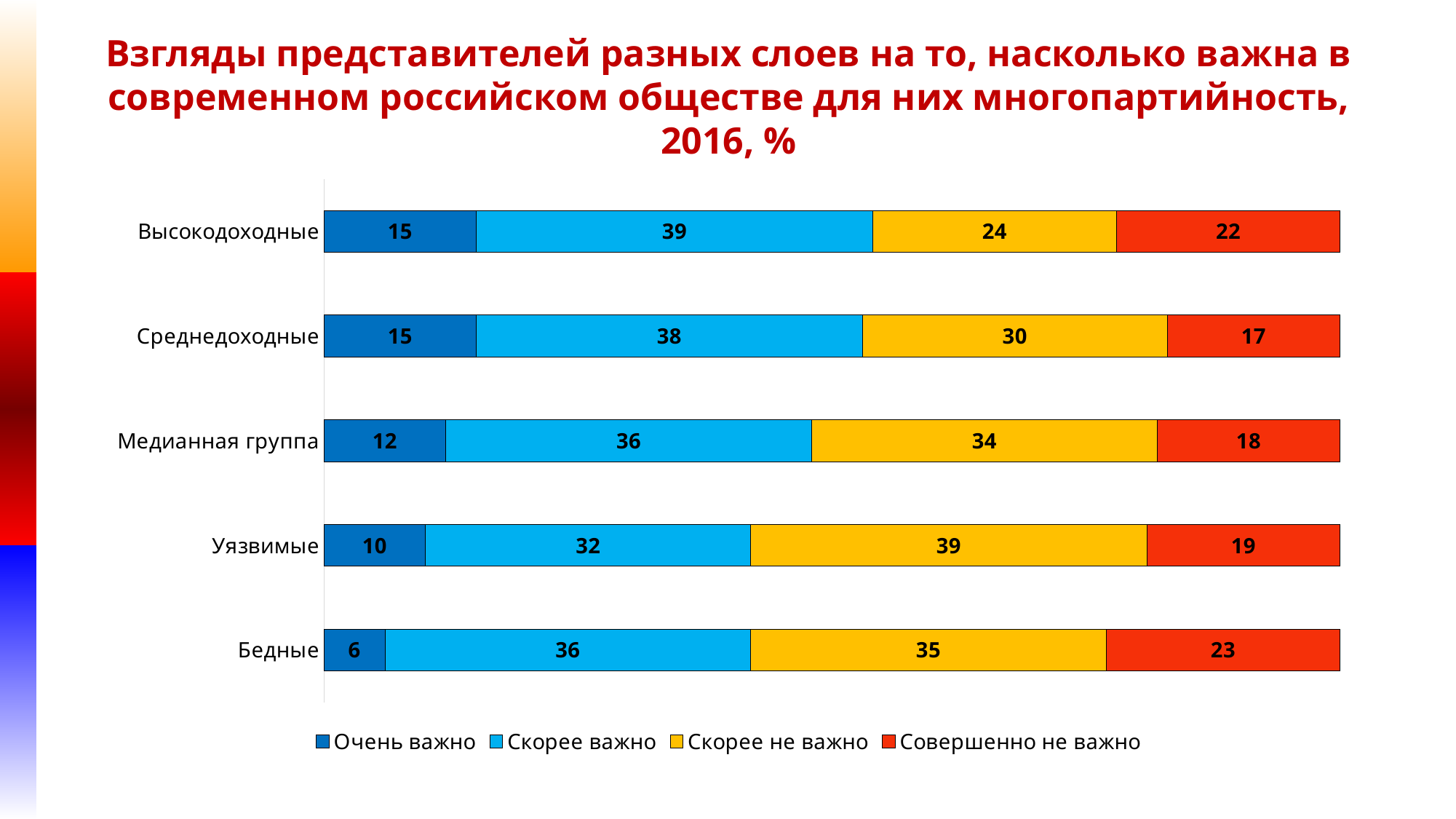
How many series does the legend list? 4 Which category has the lowest value for "Совершенно не важно"? Среднедоходные Which category has the lowest value for "Очень важно"? Бедные What is the value for "Очень важно" in the "Бедные" category? 6 What is the value for "Совершенно не важно" in the "Высокодоходные" category? 22 How many categories are shown on the chart? 5 What is the value for "Скорее не важно" in the "Уязвимые" category? 39 What is the total of the stacked bar for "Медианная группа"? 100 What is the difference between the "Скорее не важно" values for "Уязвимые" and "Высокодоходные"? 15 Which category has the highest value for "Очень важно"? Высокодоходные and Среднедоходные (15 each) Which is larger: the "Скорее важно" value for "Высокодоходные" or for "Уязвимые"? Высокодоходные What kind of chart is shown on the slide? Stacked bar chart